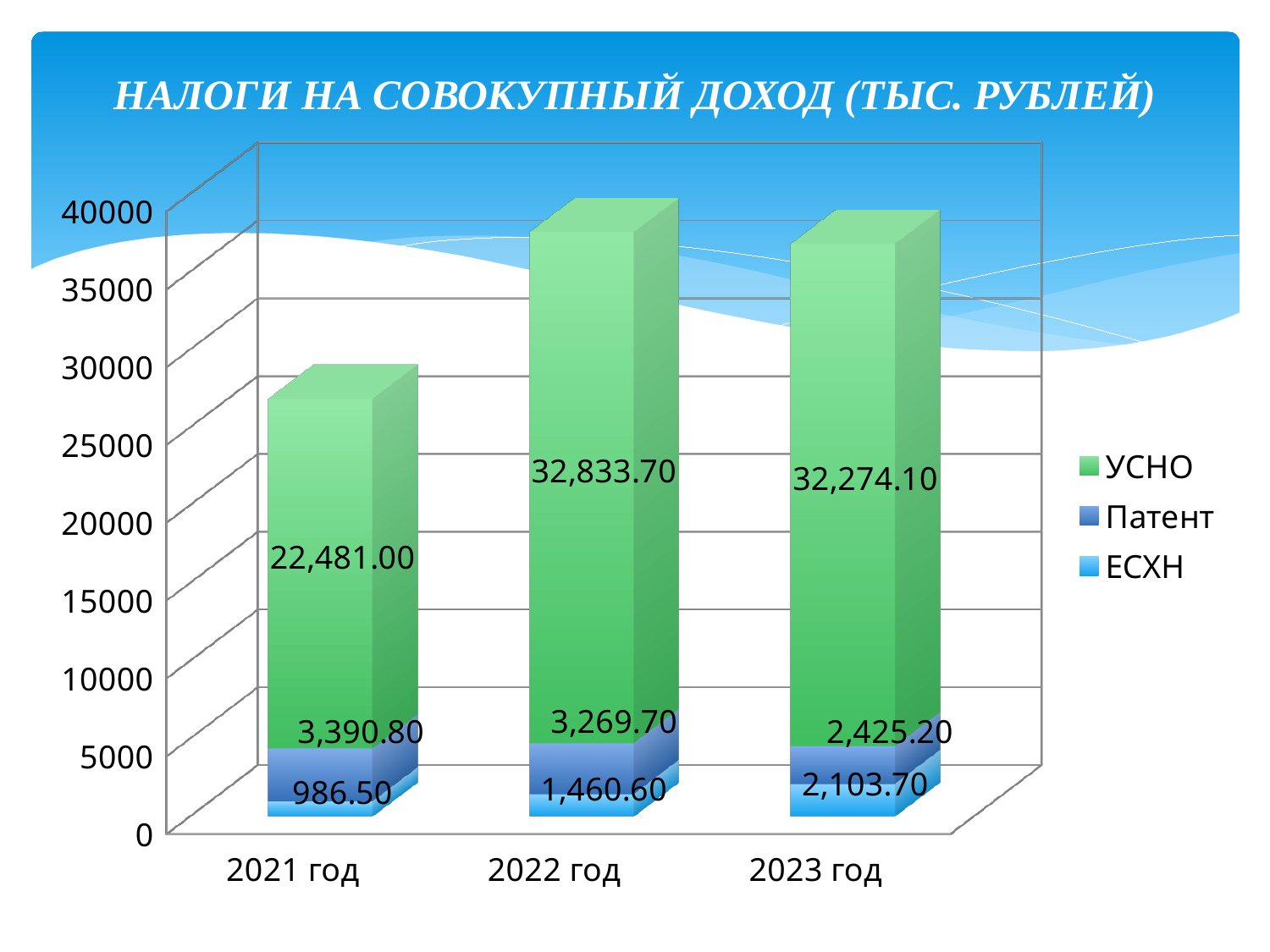
In which year is the УСНО value highest? 2022 год What is the value of Патент for 2022 год? 3,269.70 What is the total of the stacked bar for 2022 год? 37,564.00 What is the title of the chart? НАЛОГИ НА СОВОКУПНЫЙ ДОХОД (ТЫС. РУБЛЕЙ) In which year is the ЕСХН value lowest? 2021 год How many series does the legend list? 3 What is the value of УСНО for 2021 год? 22,481.00 Which is larger: the Патент value for 2021 год or for 2023 год? 2021 год What is the difference between the УСНО values for 2022 год and 2023 год? 559.60 What type of chart is shown on the slide? Stacked bar chart How many years are shown on the x axis? 3 What is the value of ЕСХН for 2023 год? 2,103.70